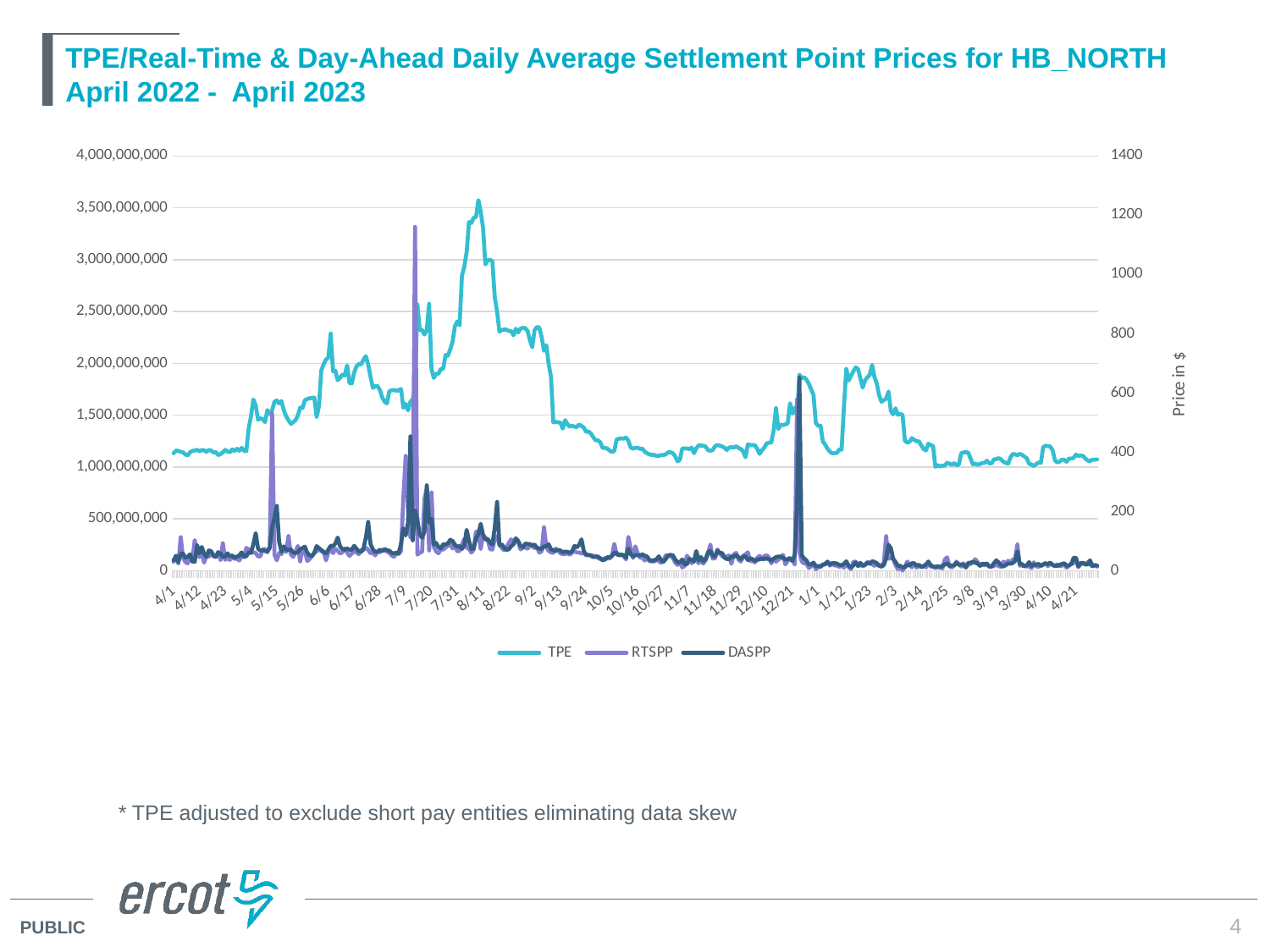
Does the TPE line rise or fall between 8/11 and 9/13? fall What kind of chart is shown on the slide? Line chart What is the highest tick value shown on the left vertical axis? 4,000,000,000 Is the peak value of the DASPP line (around 12/21) greater or less than 800 on the right axis? less Is the peak value of the TPE line (around 8/11) greater or less than 3,000,000,000 on the left axis? greater What is the label on the right-hand vertical axis? Price in $ What are the three series named in the legend? TPE, RTSPP, DASPP How many series does the legend list? 3 Does the TPE line rise or fall between 4/1 and its peak around 8/11? rise What is the highest tick value shown on the right vertical axis? 1400 Is the peak value of the RTSPP line (around 7/9) greater or less than 1000 on the right axis? greater At the spike around 7/9, which series reaches a higher value, RTSPP or DASPP? RTSPP